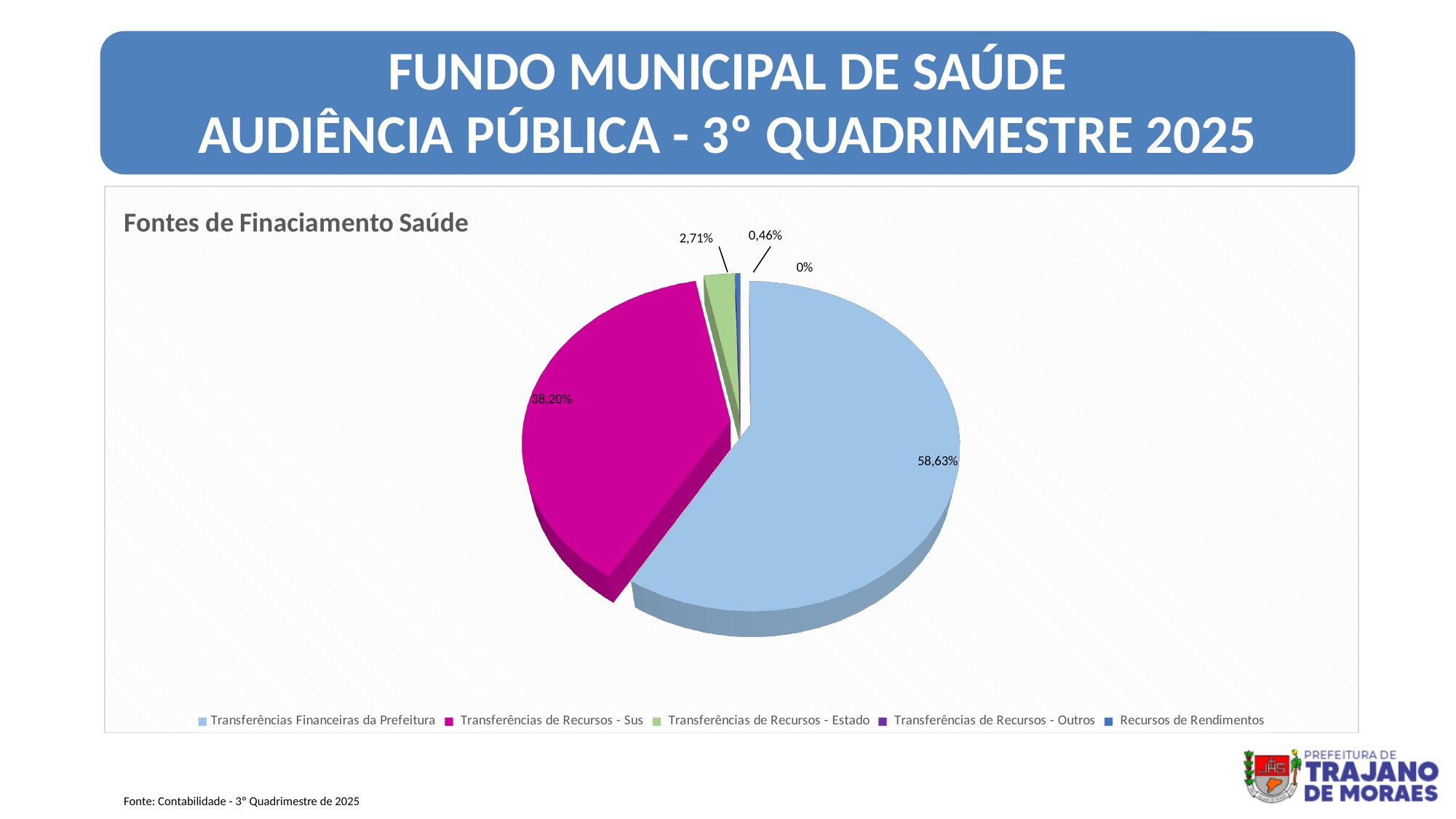
What share of the pie is Recursos de Rendimentos? 0,46% How many categories does the legend list? 5 What is the difference in percentage points between Transferências Financeiras da Prefeitura and Transferências de Recursos - Sus? 20,43% What kind of chart is shown on the slide? Pie chart What is the title of the chart? Fontes de Finaciamento Saúde Which category has the largest slice of the pie? Transferências Financeiras da Prefeitura What colour is the slice for Transferências de Recursos - Sus? Magenta Which is larger, Transferências de Recursos - Sus or Transferências de Recursos - Estado? Transferências de Recursos - Sus What is the difference in percentage points between Transferências de Recursos - Sus and Transferências de Recursos - Estado? 35,49% What share of the pie is Transferências Financeiras da Prefeitura? 58,63% What share of the pie is Transferências de Recursos - Estado? 2,71% What share of the pie is Transferências de Recursos - Sus? 38,20%